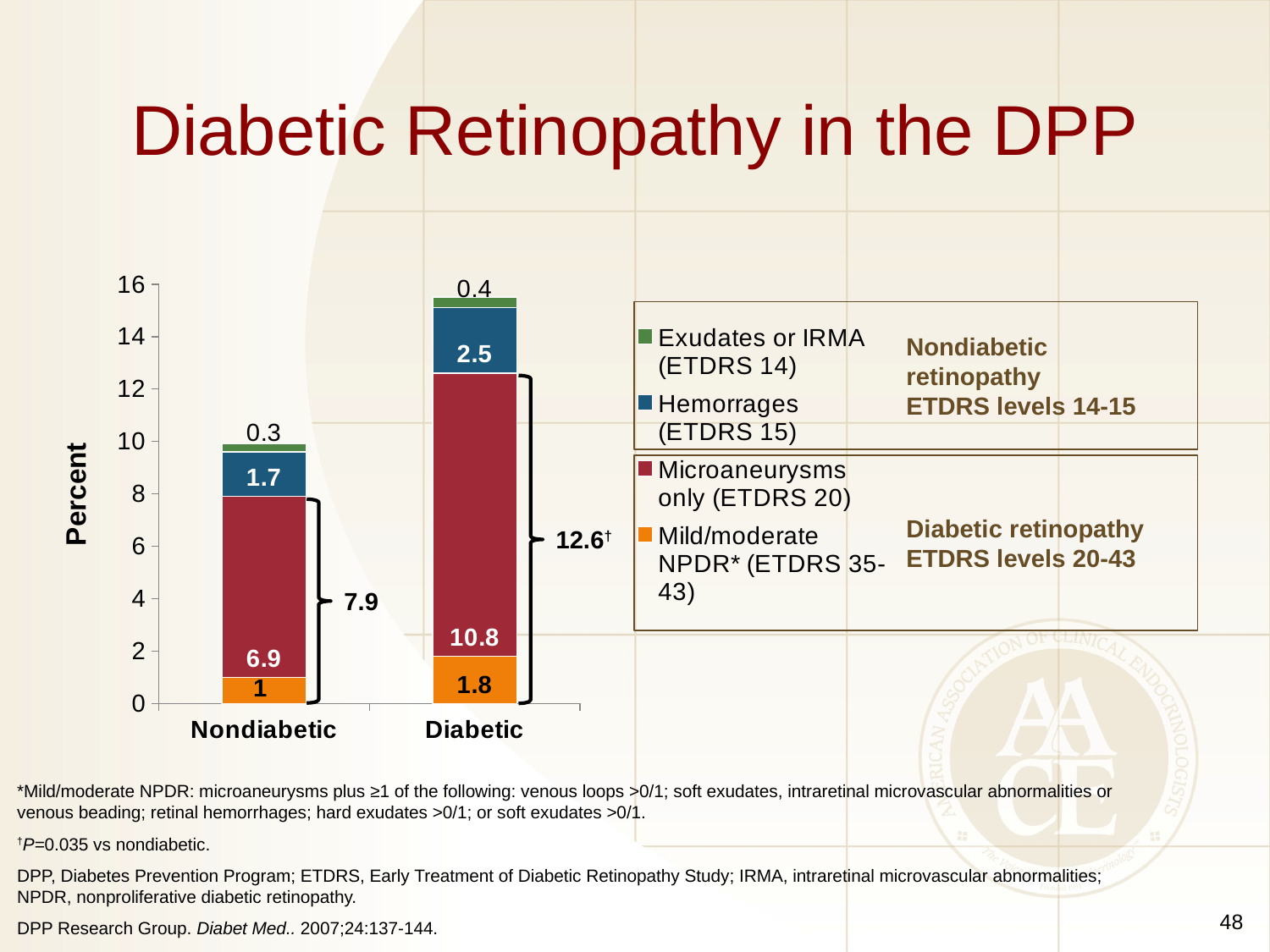
What kind of chart is shown on the slide? Stacked bar chart What is the difference between the Microaneurysms only values for the Diabetic and Nondiabetic groups? 3.9 What is the value for Exudates or IRMA (ETDRS 14) in the Nondiabetic group? 0.3 What is the value for Mild/moderate NPDR (ETDRS 35-43) in the Diabetic group? 1.8 How many categories are shown on the x axis? 2 What is the total height of the Nondiabetic stacked bar? 9.9 What is the value for Microaneurysms only (ETDRS 20) in the Diabetic group? 10.8 What is the total height of the Diabetic stacked bar? 15.5 Which group has the larger Hemorrages (ETDRS 15) value, Nondiabetic or Diabetic? Diabetic How many series does the legend list? 4 What is the bracketed diabetic retinopathy (ETDRS levels 20-43) value shown for the Diabetic group? 12.6 What is the value for Hemorrages (ETDRS 15) in the Nondiabetic group? 1.7